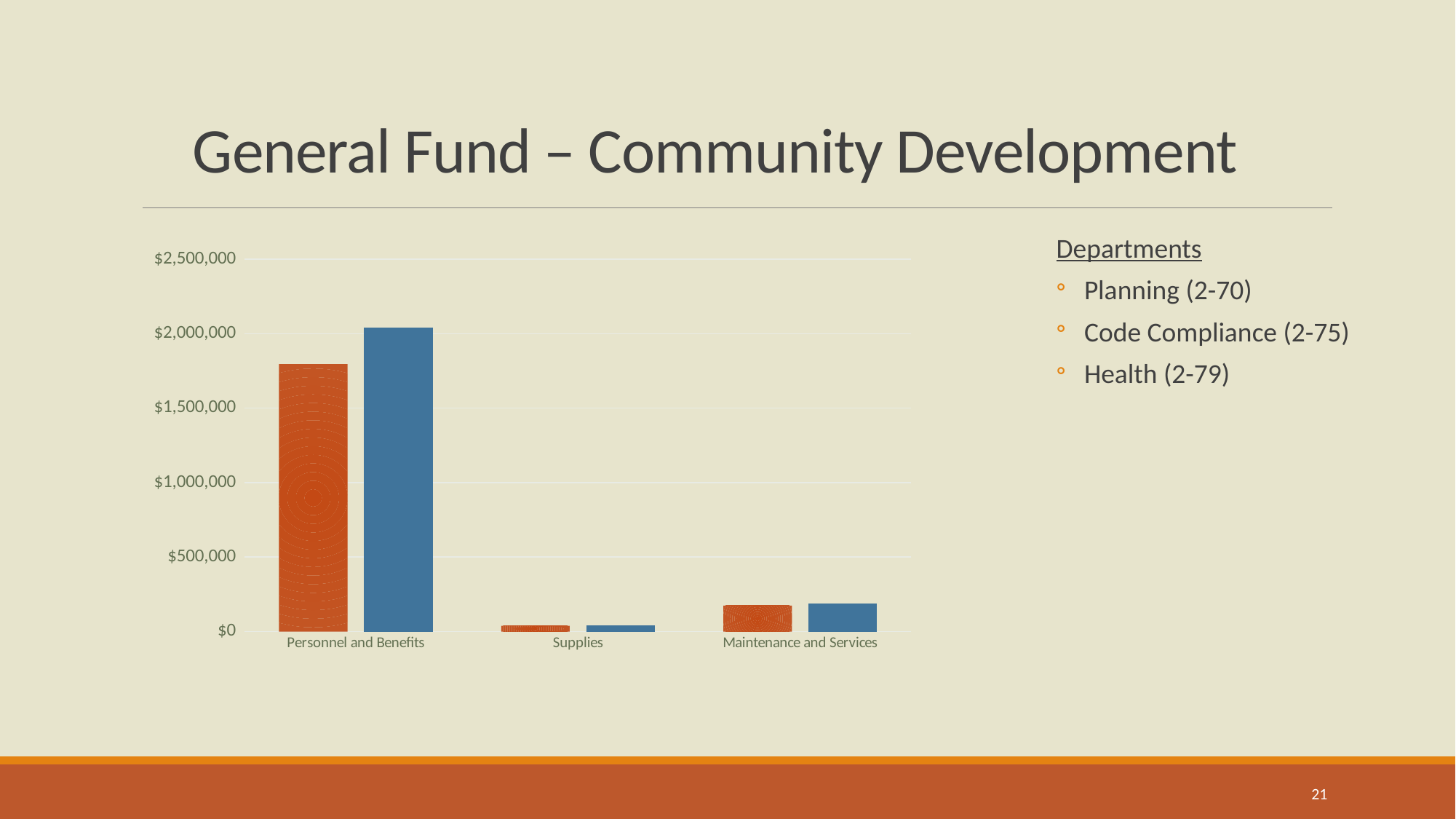
Is the blue bar for Personnel and Benefits greater or less than $1,500,000? greater Is the orange bar for Personnel and Benefits greater or less than $1,500,000? greater Which category has the shortest bars in the chart? Supplies Which category has the tallest bars in the chart? Personnel and Benefits For Personnel and Benefits, which bar is taller, the orange one or the blue one? the blue one Is the blue bar for Maintenance and Services greater or less than $500,000? less What kind of chart is shown on the slide? bar chart What two colours are used for the bars in the chart? orange and blue What is the highest value labelled on the vertical axis of the chart? $2,500,000 Which category has larger values, Supplies or Maintenance and Services? Maintenance and Services How many categories are shown on the x axis of the chart? 3